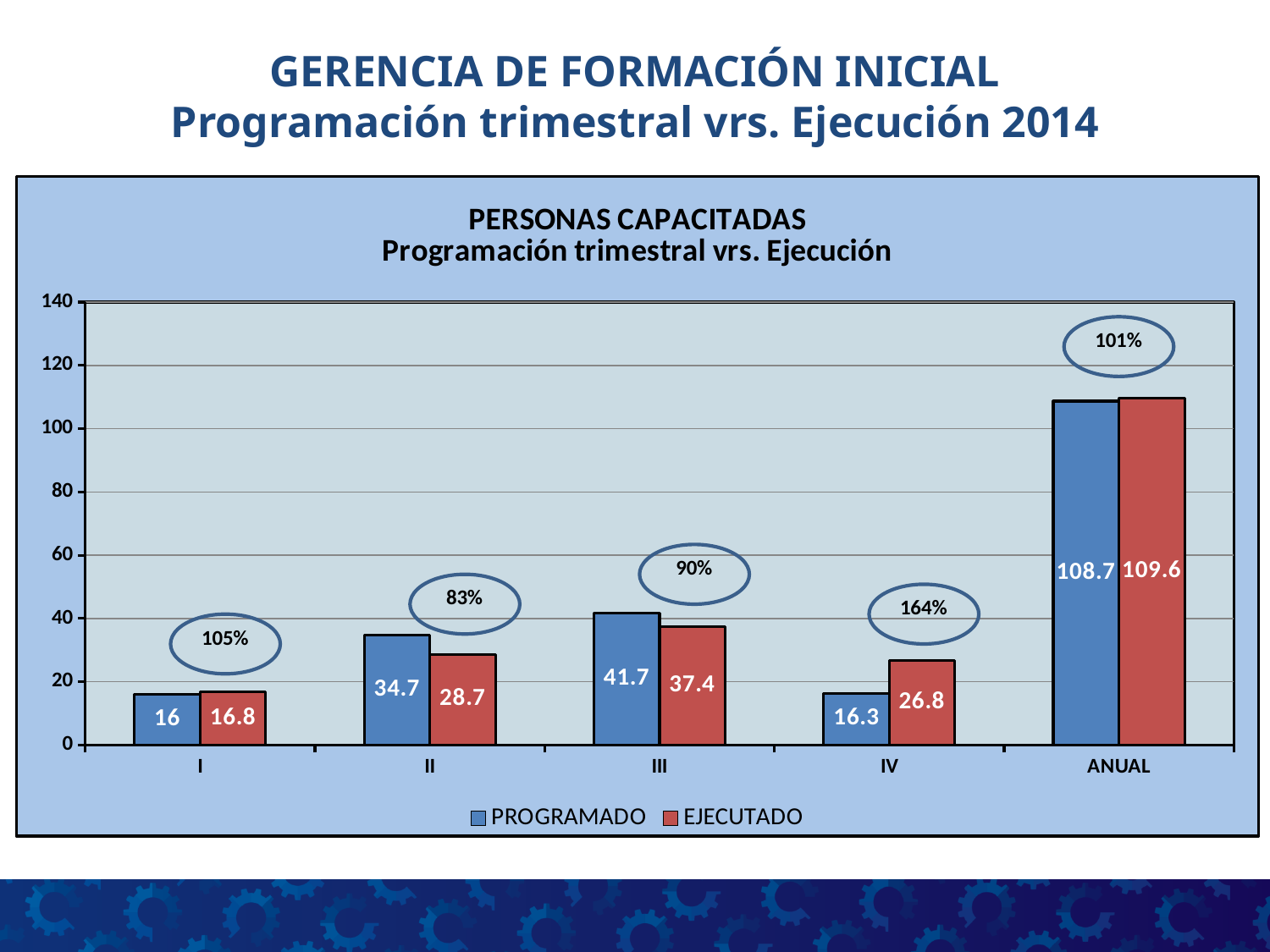
For quarter IV, which is larger: PROGRAMADO or EJECUTADO? EJECUTADO What is the PROGRAMADO value for quarter III? 41.7 What kind of chart is shown? bar chart What is the EJECUTADO value for ANUAL? 109.6 How many series does the legend list? 2 What percentage is shown in the circle above the ANUAL bars? 101% What is the EJECUTADO value for quarter IV? 26.8 What is the difference between the PROGRAMADO and EJECUTADO values for quarter II? 6 How many categories are shown on the x axis? 5 Among the quarters I to IV, which has the lowest EJECUTADO value? I Which category has the highest PROGRAMADO value? ANUAL What colour are the EJECUTADO bars? red